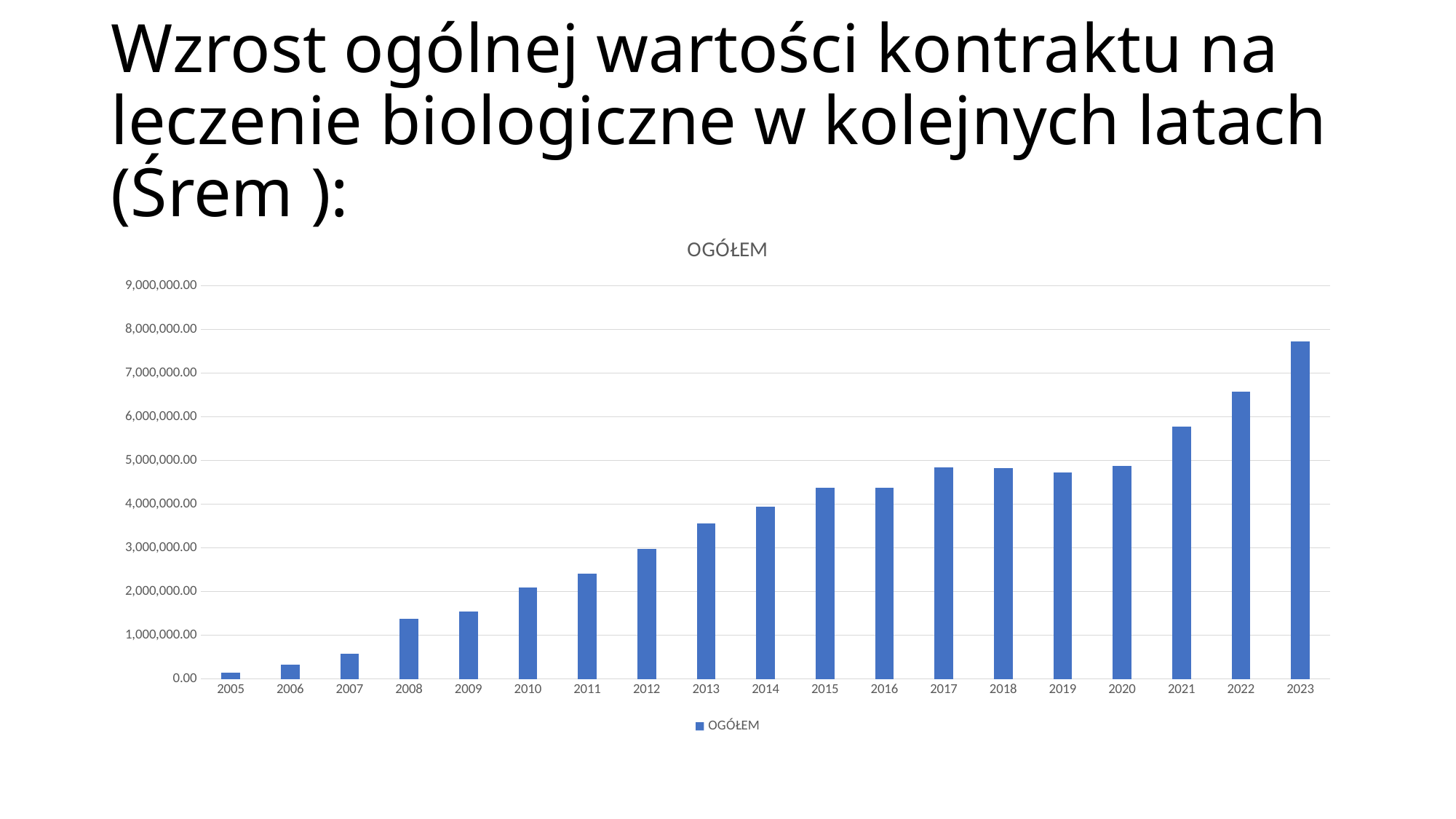
How many series does the legend list? 1 Which year has the highest value in the chart? 2023 How many years are shown on the x axis of the chart? 19 Is the value for 2023 greater or less than 7,000,000.00? greater What kind of chart is shown on the slide? bar chart Do the values generally rise or fall from 2005 to 2023? rise Is the value for 2013 greater or less than 3,000,000.00? greater Which year has the larger value, 2020 or 2021? 2021 What is the title of the chart? OGÓŁEM Which year has the lowest value in the chart? 2005 Is the value for 2005 greater or less than 1,000,000.00? less